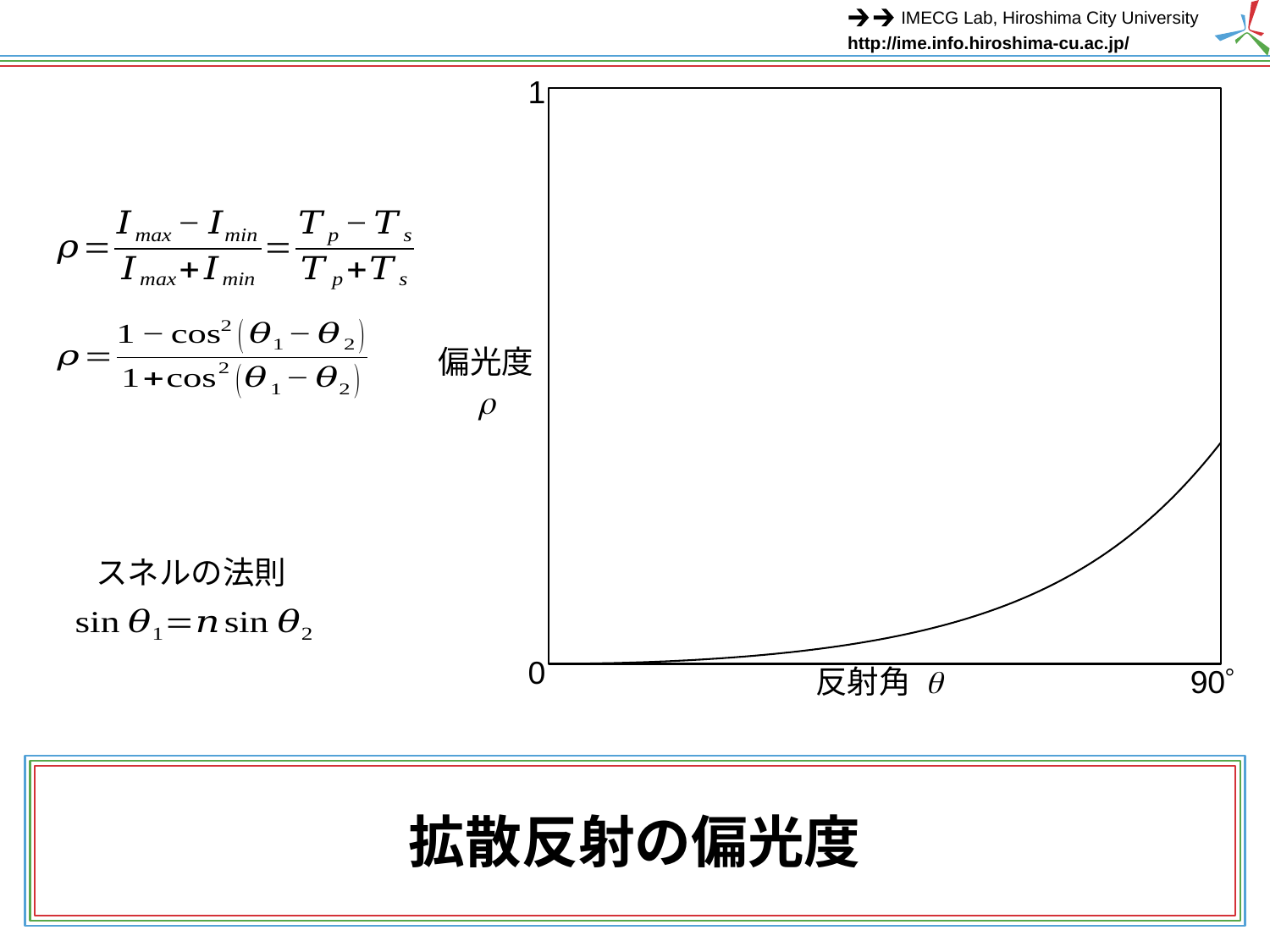
What is the maximum value shown on the x axis of the chart? 90° How many lines are plotted on the chart? 1 Is the value of 偏光度 ρ at a reflection angle of 90° greater or less than 1? less Does the degree of polarization (偏光度 ρ) rise or fall as the reflection angle (反射角 θ) increases from 0 to 90°? rise At which end of the x axis, 0 or 90°, is the plotted 偏光度 ρ higher? 90° What is the label of the x axis of the chart? 反射角 θ What is the label of the y axis of the chart? 偏光度 ρ What is the maximum value shown on the y axis of the chart? 1 What kind of chart is shown on the slide? line chart